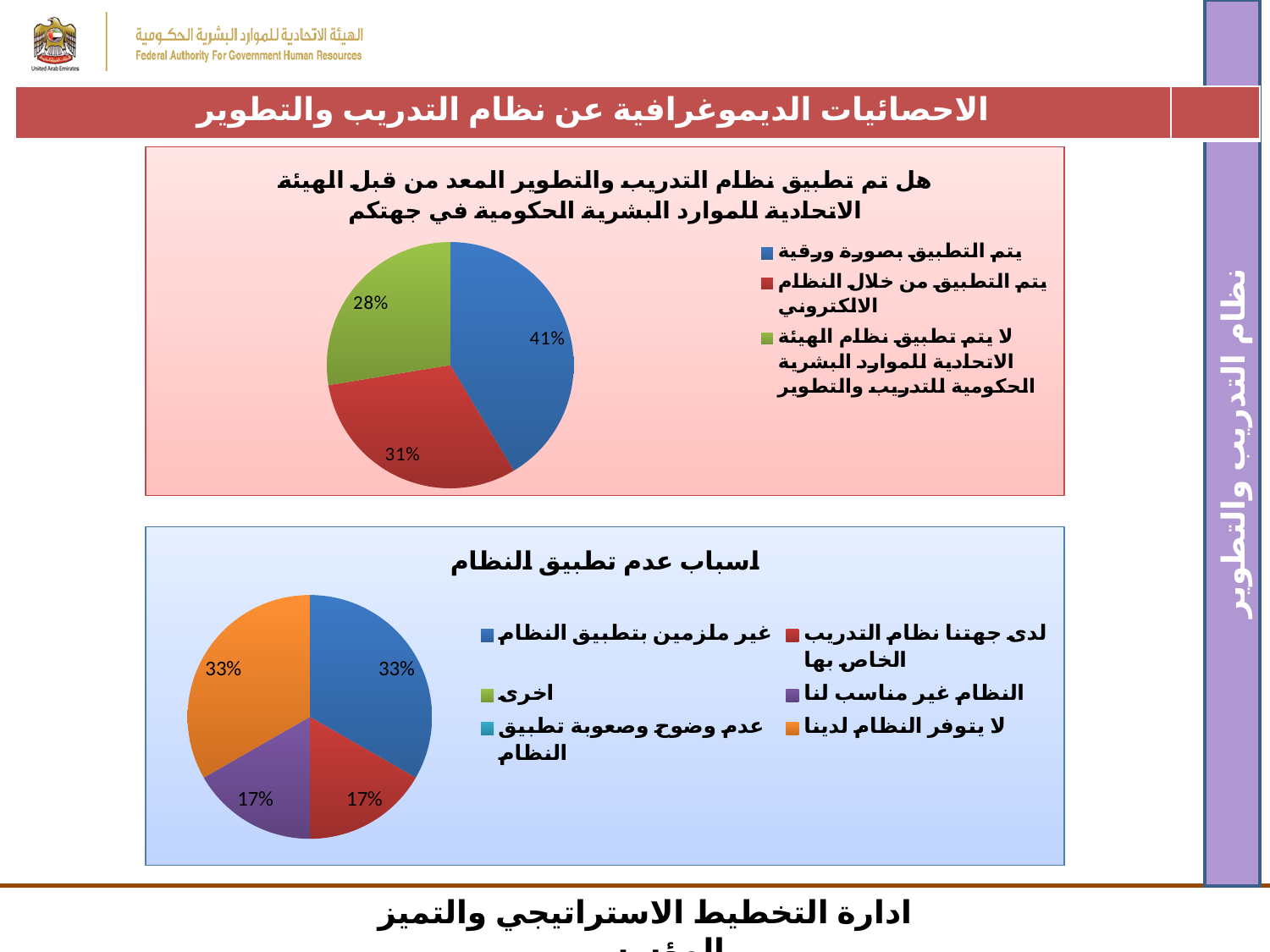
How many entries does the legend of the bottom chart list? 6 In the bottom chart, which is larger: 'لا يتوفر النظام لدينا' or 'لدى جهتنا نظام التدريب الخاص بها'? لا يتوفر النظام لدينا In the top chart (هل تم تطبيق نظام التدريب والتطوير...), what percentage is shown for 'يتم التطبيق بصورة ورقية'? 41% In the top chart, what percentage is shown for 'يتم التطبيق من خلال النظام الالكتروني'? 31% In the top chart, which category has the smallest share? لا يتم تطبيق نظام الهيئة الاتحادية للموارد البشرية الحكومية للتدريب والتطوير In the bottom chart, what percentage is shown for 'النظام غير مناسب لنا'? 17% In the top chart, what percentage is shown for 'لا يتم تطبيق نظام الهيئة الاتحادية للموارد البشرية الحكومية للتدريب والتطوير'? 28% In the bottom chart (اسباب عدم تطبيق النظام), what percentage is shown for 'غير ملزمين بتطبيق النظام'? 33% What is the title of the bottom chart? اسباب عدم تطبيق النظام In the top chart, which category has the largest share? يتم التطبيق بصورة ورقية What type of chart is the top chart? Pie chart In the top chart, what is the difference in percentage points between 'يتم التطبيق بصورة ورقية' and 'يتم التطبيق من خلال النظام الالكتروني'? 10 percentage points